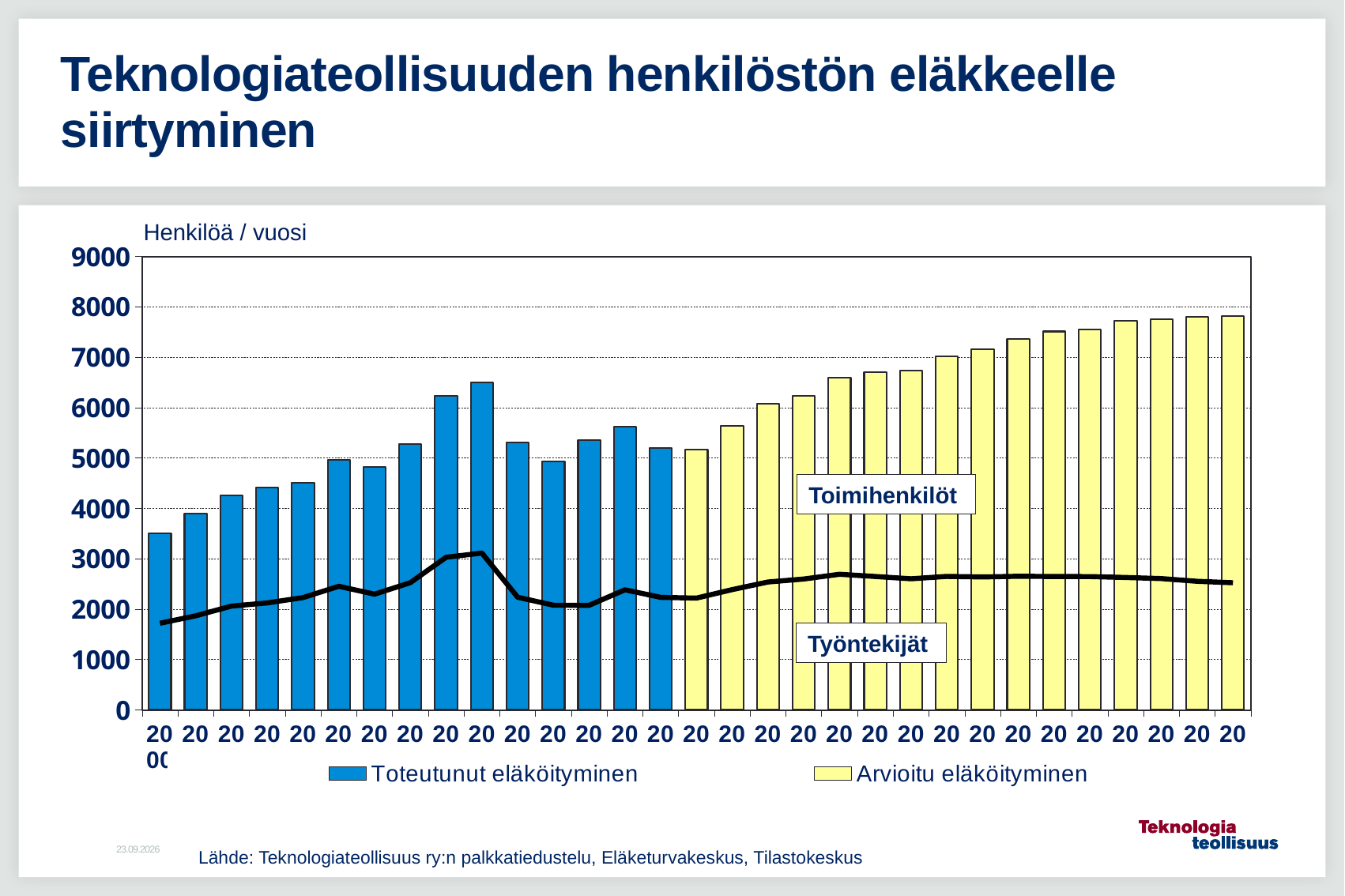
Which series is drawn with blue bars? Toteutunut eläköityminen What is the label shown above the vertical axis? Henkilöä / vuosi Is the last (rightmost) yellow bar greater or less than 7000? greater Is the tallest blue bar (Toteutunut eläköityminen) greater or less than 6000? greater Is the value of the black line at the leftmost point greater or less than 2000? less How many blue Toteutunut eläköityminen bars are plotted? 15 How many series does the legend list? 2 Do the yellow Arvioitu eläköityminen bars generally rise or fall from left to right? rise What are the two series named in the legend? Toteutunut eläköityminen and Arvioitu eläköityminen What kind of chart is shown on the slide? bar and line chart Which series contains the tallest bar on the chart, Toteutunut eläköityminen or Arvioitu eläköityminen? Arvioitu eläköityminen